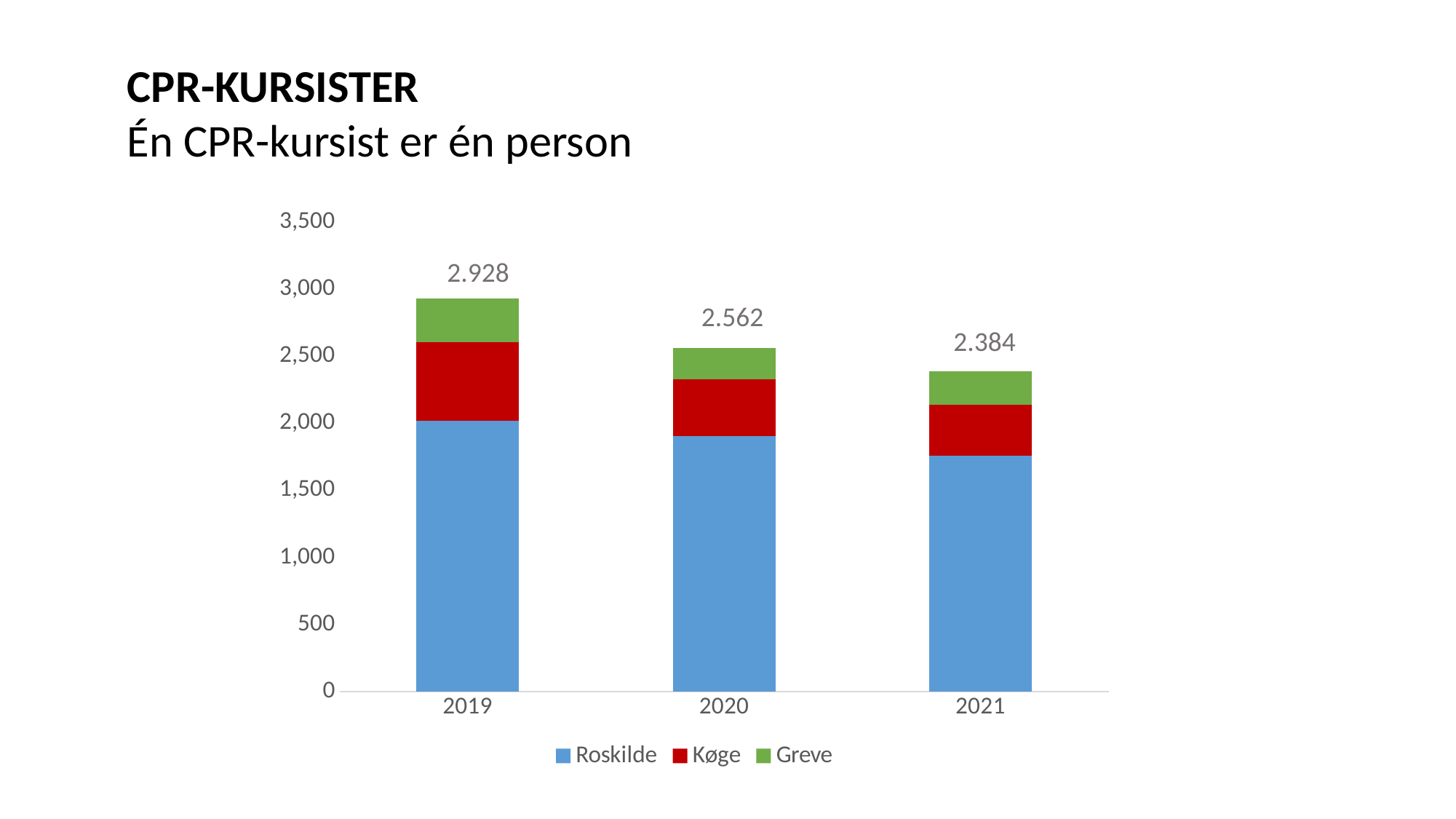
What is the total number of CPR-kursister shown for 2019? 2.928 Is the Roskilde value for 2020 greater or less than 2,000? less Is the Roskilde value for 2021 greater or less than 1,500? greater Is the total for 2020 larger or smaller than the total for 2021? larger What is the total number of CPR-kursister shown for 2021? 2.384 How many years are shown on the x axis? 3 Which year has the highest total of CPR-kursister? 2019 Which year has the lowest total of CPR-kursister? 2021 What kind of chart is shown on the slide? Stacked bar chart How many series does the legend list? 3 Do the totals rise or fall from 2019 to 2021? fall By how much does the 2019 total exceed the 2020 total? 366